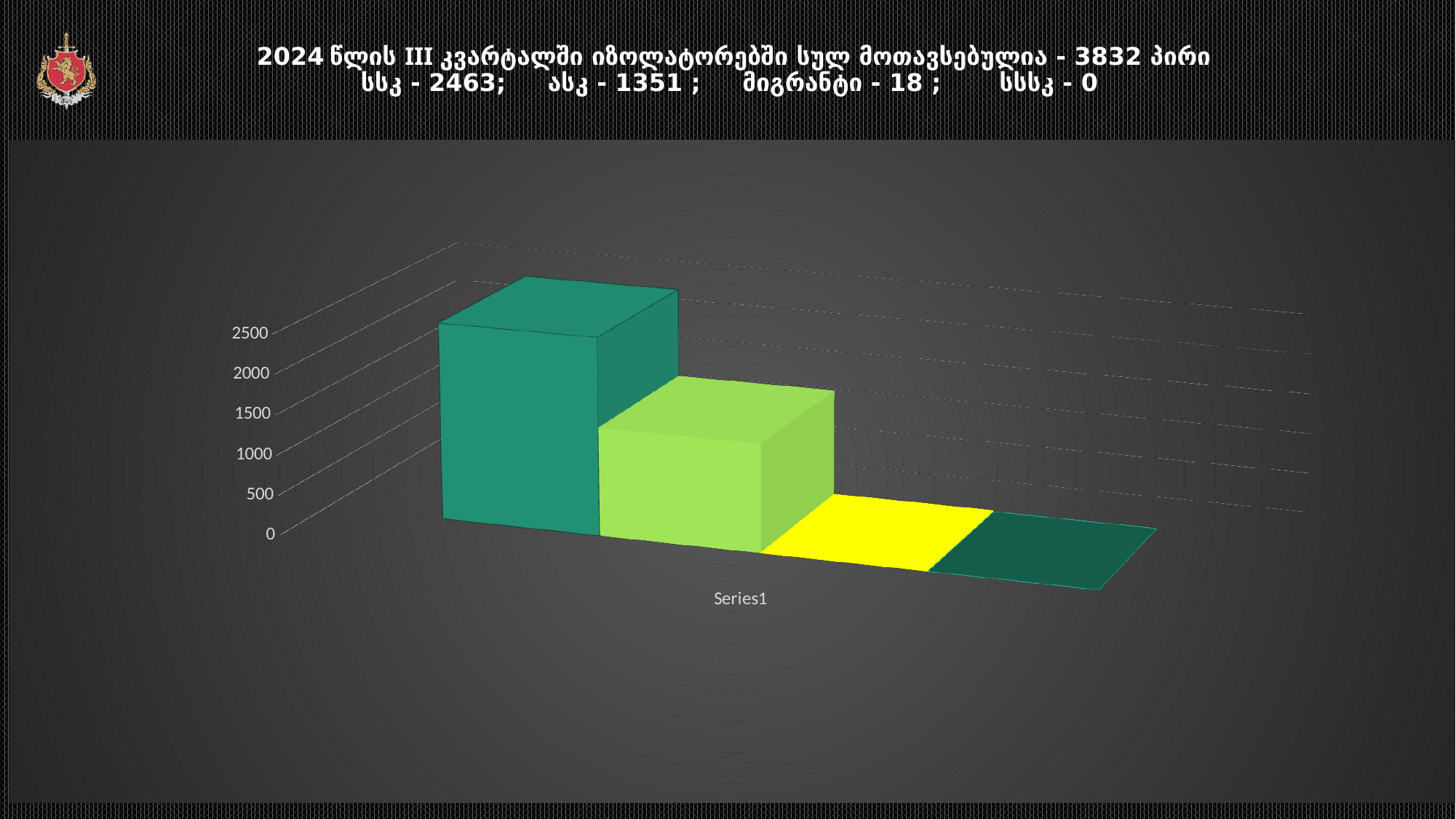
Is the value of the third bar from the left (yellow) greater or less than 500? less How many bars are plotted in the chart? 4 According to the slide title, what is the value given for სსკ? 2463 Is the value of the tallest (leftmost) bar greater or less than 2000? greater What is the highest value shown on the vertical axis of the chart? 2500 What kind of chart is shown on the slide? bar chart Do the bar values rise or fall from left to right across the chart? fall Is the value of the second bar from the left greater or less than 1500? less Which bar is the tallest: the leftmost bar or the second bar from the left? the leftmost bar According to the slide title, what is the total number of persons placed in isolators in Q3 2024? 3832 What is the label shown on the horizontal axis of the chart? Series1